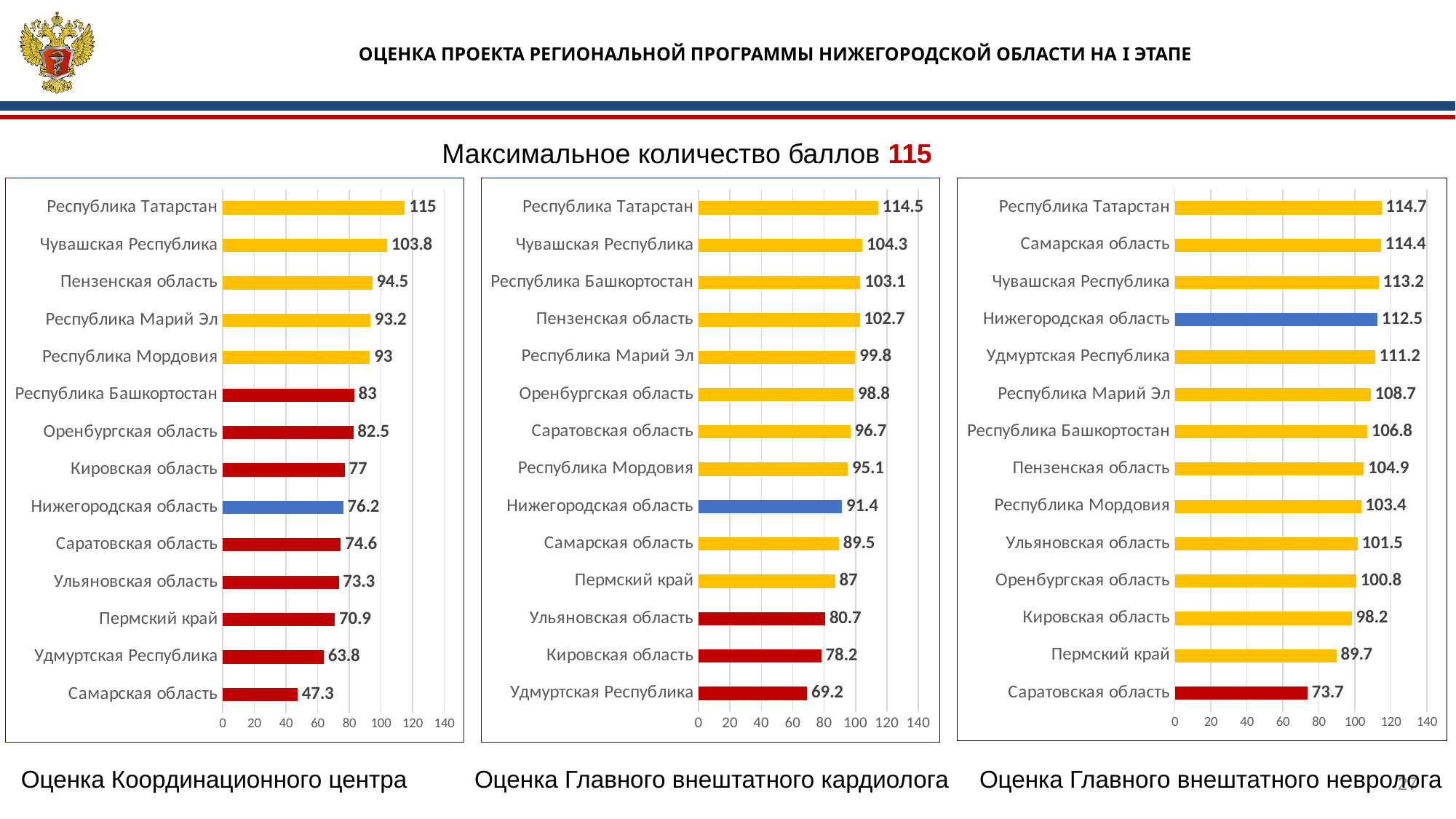
In the left chart (Оценка Координационного центра), which region has the lowest value? Самарская область What type of chart is the left chart (Оценка Координационного центра)? bar chart In the right chart (Оценка Главного внештатного невролога), which region has the lowest value? Саратовская область How many regions are shown in the middle chart (Оценка Главного внештатного кардиолога)? 14 In the left chart (Оценка Координационного центра), what is the value for Нижегородская область? 76.2 In the right chart (Оценка Главного внештатного невролога), is the value for Пермский край greater or less than 100? less In the middle chart (Оценка Главного внештатного кардиолога), what is the value for Республика Башкортостан? 103.1 In the right chart (Оценка Главного внештатного невролога), what colour is the bar for Нижегородская область? blue In the middle chart (Оценка Главного внештатного кардиолога), which is larger: the value for Пермский край or the value for Ульяновская область? Пермский край In the middle chart (Оценка Главного внештатного кардиолога), which region has the highest value? Республика Татарстан In the right chart (Оценка Главного внештатного невролога), what is the value for Самарская область? 114.4 In the left chart (Оценка Координационного центра), what is the difference between Республика Татарстан and Самарская область? 67.7